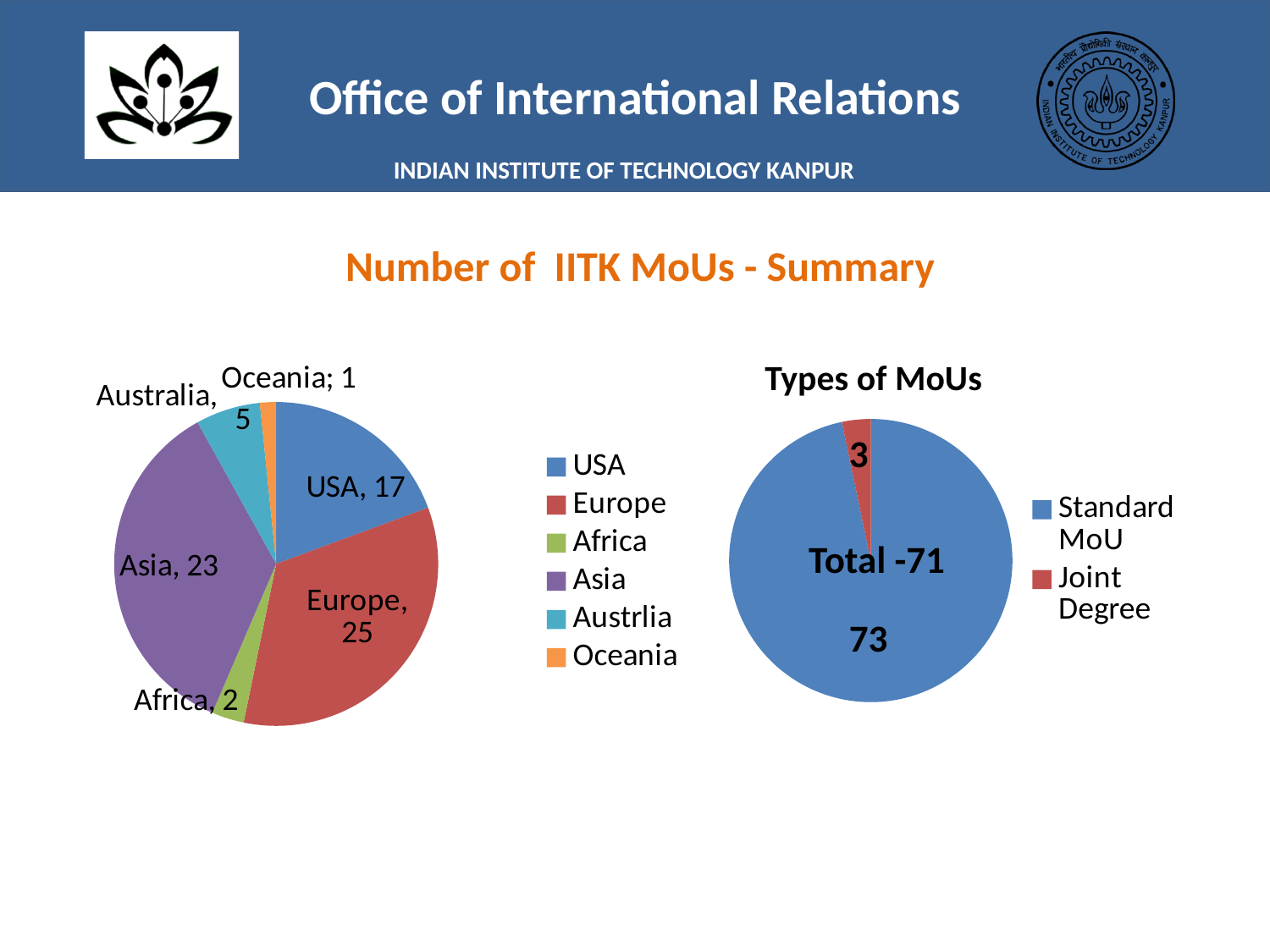
How many regions are shown in the left pie chart? 6 In the 'Types of MoUs' chart, how many Joint Degree MoUs are there? 3 In the 'Types of MoUs' chart, how many Standard MoUs are there? 73 In the left pie chart, how many MoUs are with Asia? 23 What type of chart is the 'Types of MoUs' chart? Pie chart In the left pie chart, what is the difference between the number of MoUs for Europe and for USA? 8 In the left pie chart, which region has the largest number of MoUs? Europe In the left pie chart, how many MoUs are with Europe? 25 In the left pie chart, which has more MoUs, Asia or USA? Asia In the left pie chart, which region has the smallest number of MoUs? Oceania In the 'Types of MoUs' chart, what is the difference between Standard MoU and Joint Degree counts? 70 What colour is the Joint Degree slice in the 'Types of MoUs' chart? Red